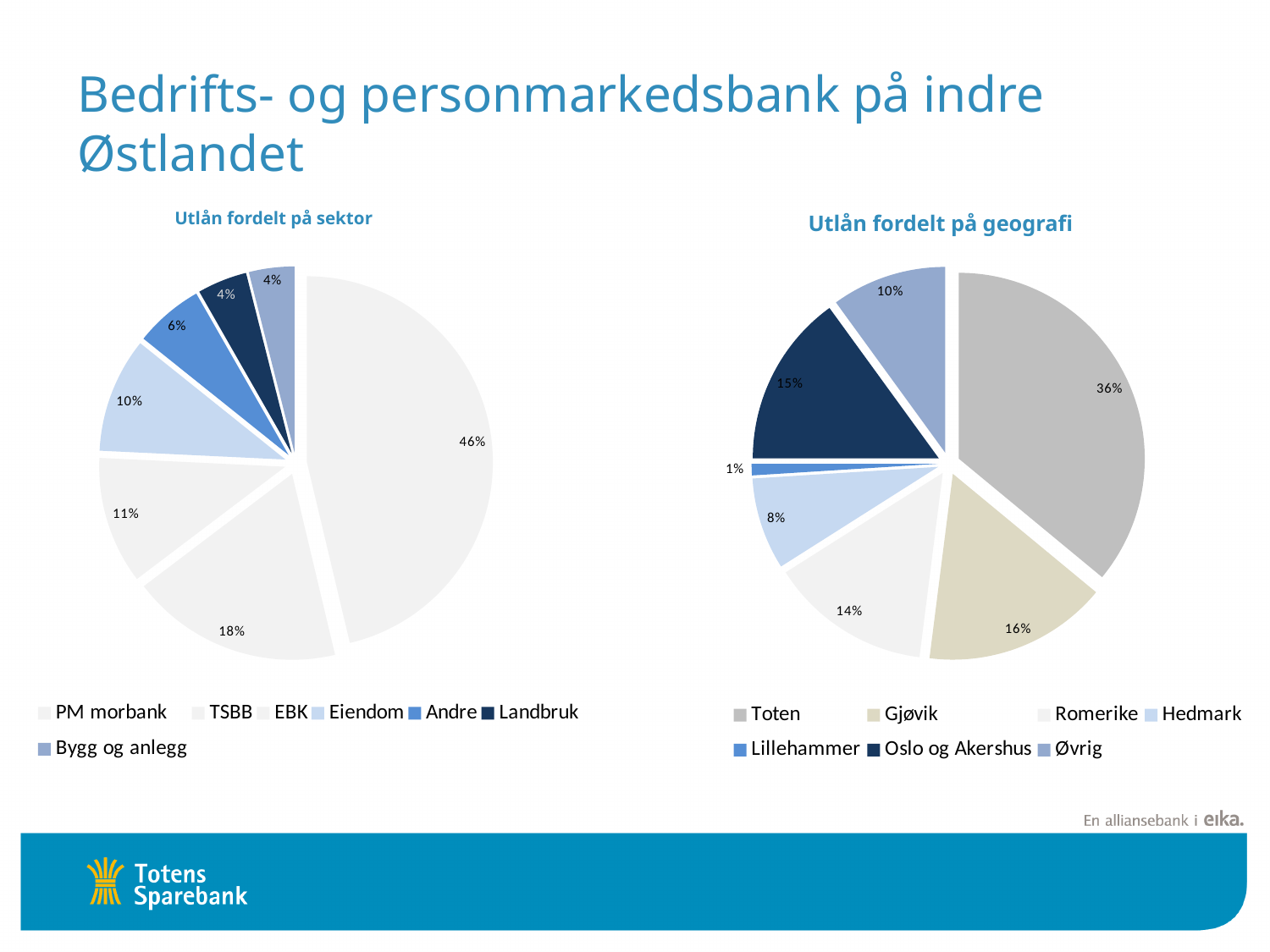
In the 'Utlån fordelt på sektor' chart, what is the share for TSBB? 18% In the 'Utlån fordelt på geografi' chart, what is the share for Oslo og Akershus? 15% In the 'Utlån fordelt på sektor' chart, which sector has the largest share? PM morbank In the 'Utlån fordelt på sektor' chart, what share of lending goes to PM morbank? 46% What type of chart is used for 'Utlån fordelt på geografi'? Pie chart In the 'Utlån fordelt på geografi' chart, which region has the smallest share? Lillehammer In the 'Utlån fordelt på sektor' chart, how many sectors are shown in the legend? 7 In the 'Utlån fordelt på geografi' chart, which is larger, the share for Gjøvik or the share for Romerike? Gjøvik In the 'Utlån fordelt på geografi' chart, what is the difference in percentage points between Toten and Gjøvik? 20 percentage points